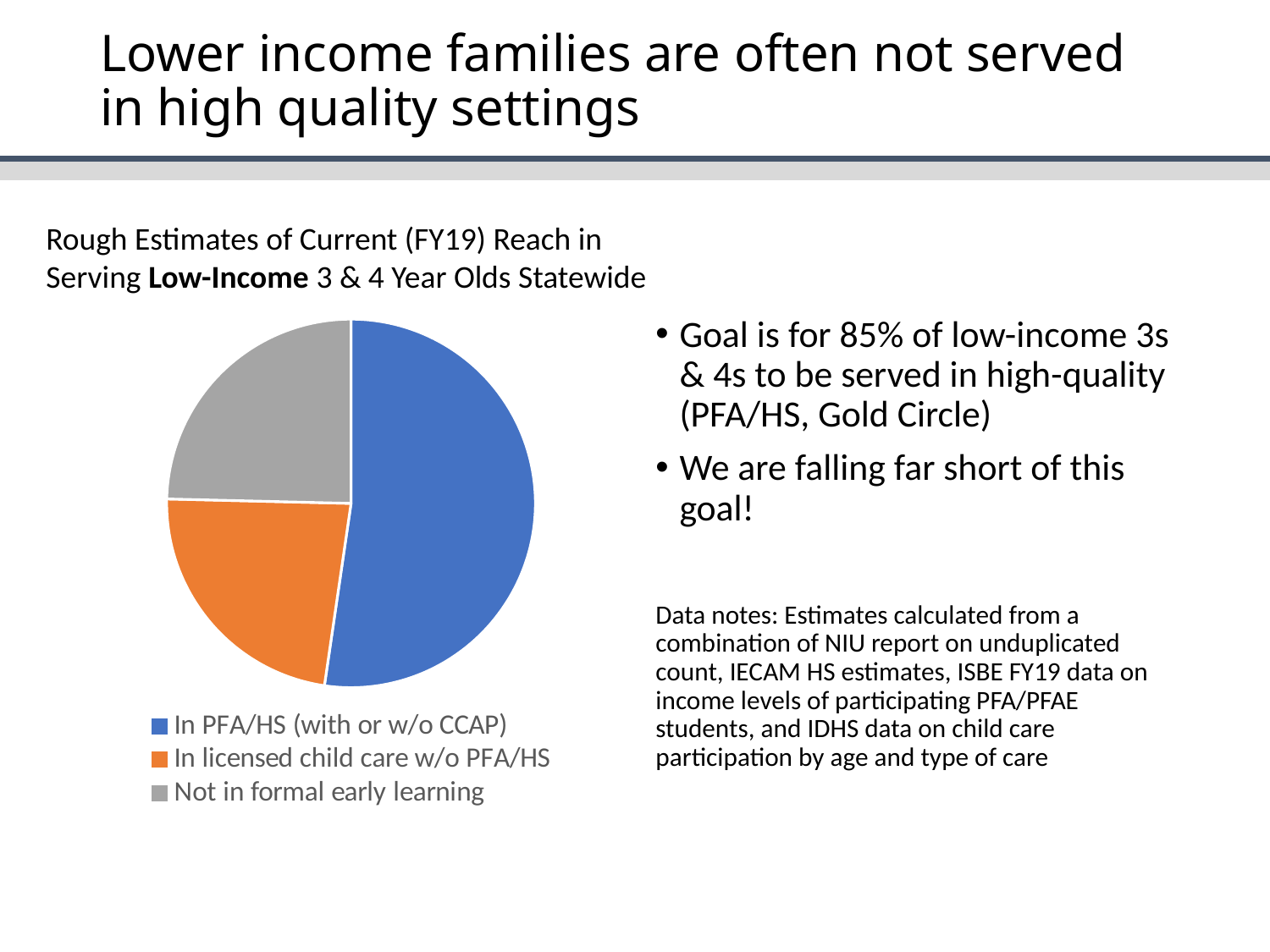
How many entries does the legend of the pie chart list? 3 How many slices does the pie chart have? 3 Which category has the largest slice of the pie chart? In PFA/HS (with or w/o CCAP) Which colour represents 'Not in formal early learning' in the pie chart? gray Which slice is larger: 'In PFA/HS (with or w/o CCAP)' or 'In licensed child care w/o PFA/HS'? In PFA/HS (with or w/o CCAP) What kind of chart is shown on the slide? pie chart What is the title of the pie chart? Rough Estimates of Current (FY19) Reach in Serving Low-Income 3 & 4 Year Olds Statewide Which slice is larger: 'In PFA/HS (with or w/o CCAP)' or 'Not in formal early learning'? In PFA/HS (with or w/o CCAP)